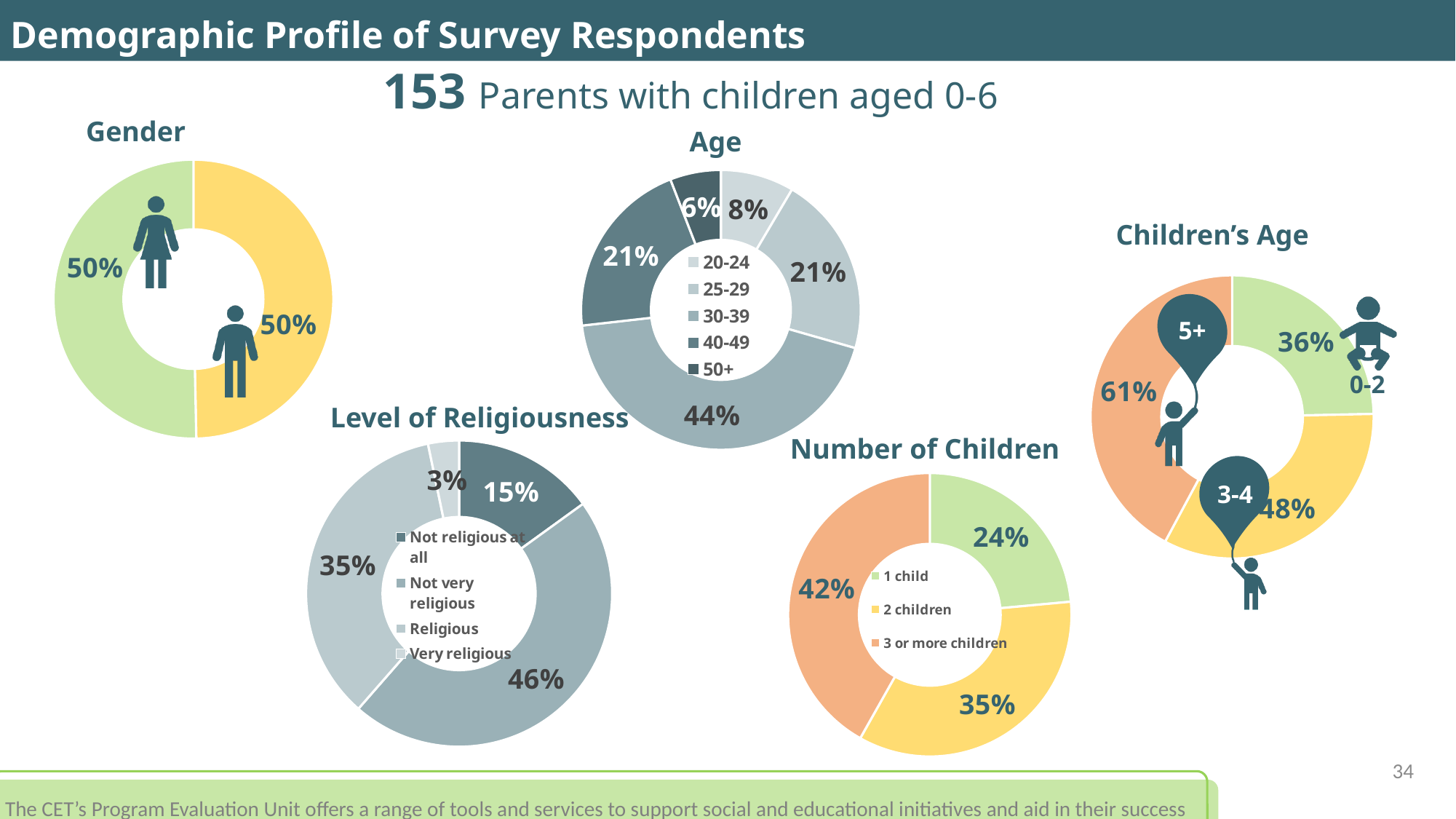
In the Number of Children chart, what percentage of respondents have 2 children? 35% In the Age chart, which age group has the smallest share? 50+ In the Children's Age chart, what percentage is shown for children aged 5+? 61% In the Number of Children chart, which is larger: the share with 1 child or the share with 3 or more children? 3 or more children What type of chart is used for the Number of Children data? Donut (pie) chart In the Gender chart, what percentage of respondents are male? 50% In the Children's Age chart, what is the difference between the 3-4 share and the 0-2 share? 12% In the Level of Religiousness chart, which category has the largest share? Not very religious In the Level of Religiousness chart, what percentage of respondents are 'Very religious'? 3% In the Age chart, what is the difference between the 30-39 share and the 25-29 share? 23% In the Age chart, what percentage of respondents are aged 30-39? 44% How many age groups does the legend of the Age chart list? 5